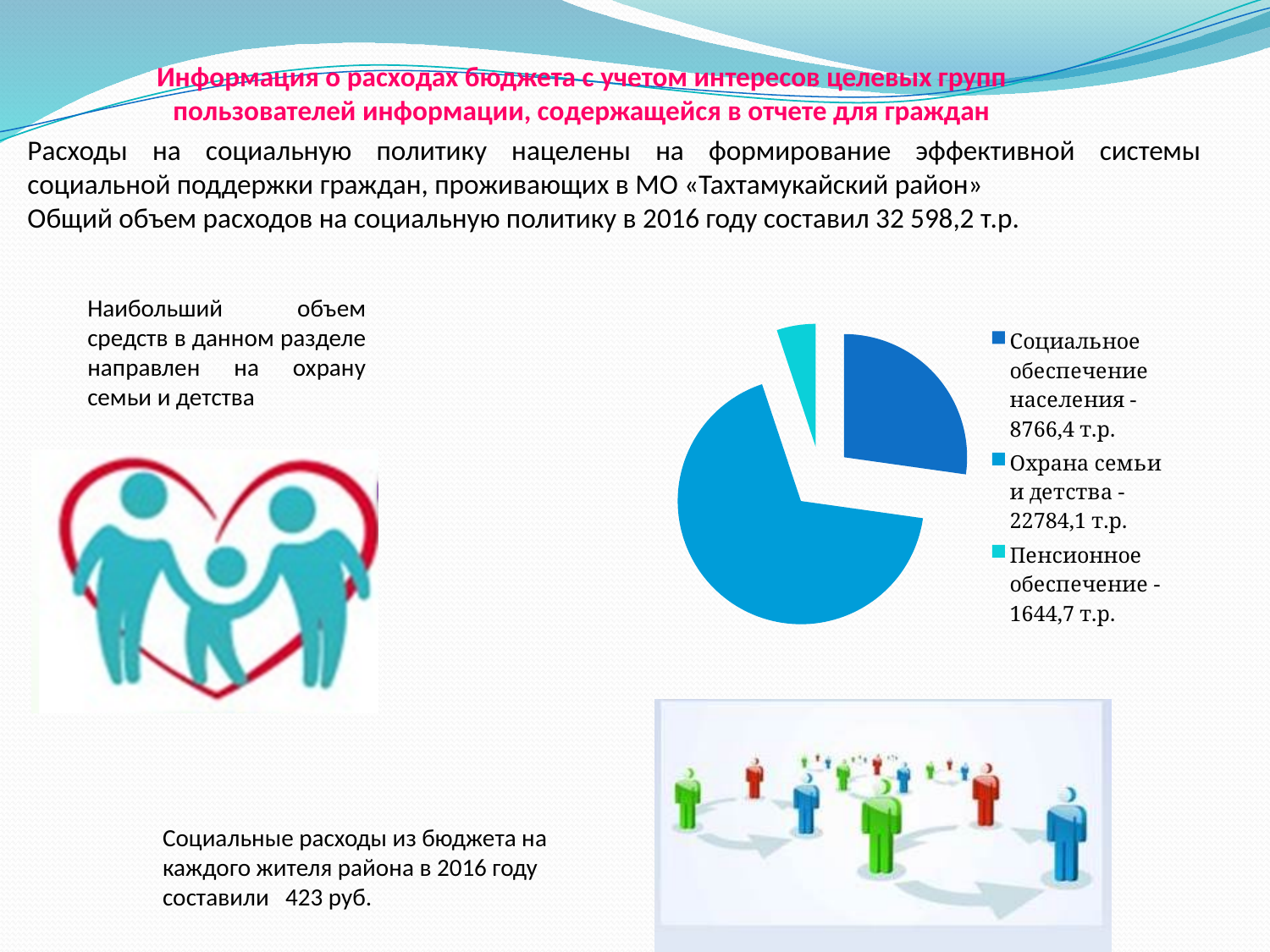
What is the difference between "Социальное обеспечение населения" and "Пенсионное обеспечение"? 7121,7 т.р. What kind of chart is shown on the slide? Pie chart Which colour is used for the "Пенсионное обеспечение" slice in the pie chart? Light blue (turquoise) What value does the legend give for "Социальное обеспечение населения"? 8766,4 т.р. Which category has the smallest slice of the pie chart? Пенсионное обеспечение How many slices does the pie chart have? 3 How many entries does the legend of the pie chart list? 3 What value does the legend give for "Охрана семьи и детства"? 22784,1 т.р. What is the difference between "Охрана семьи и детства" and "Социальное обеспечение населения"? 14017,7 т.р. Which is larger: "Социальное обеспечение населения" or "Пенсионное обеспечение"? Социальное обеспечение населения Which category has the largest slice of the pie chart? Охрана семьи и детства What value does the legend give for "Пенсионное обеспечение"? 1644,7 т.р.